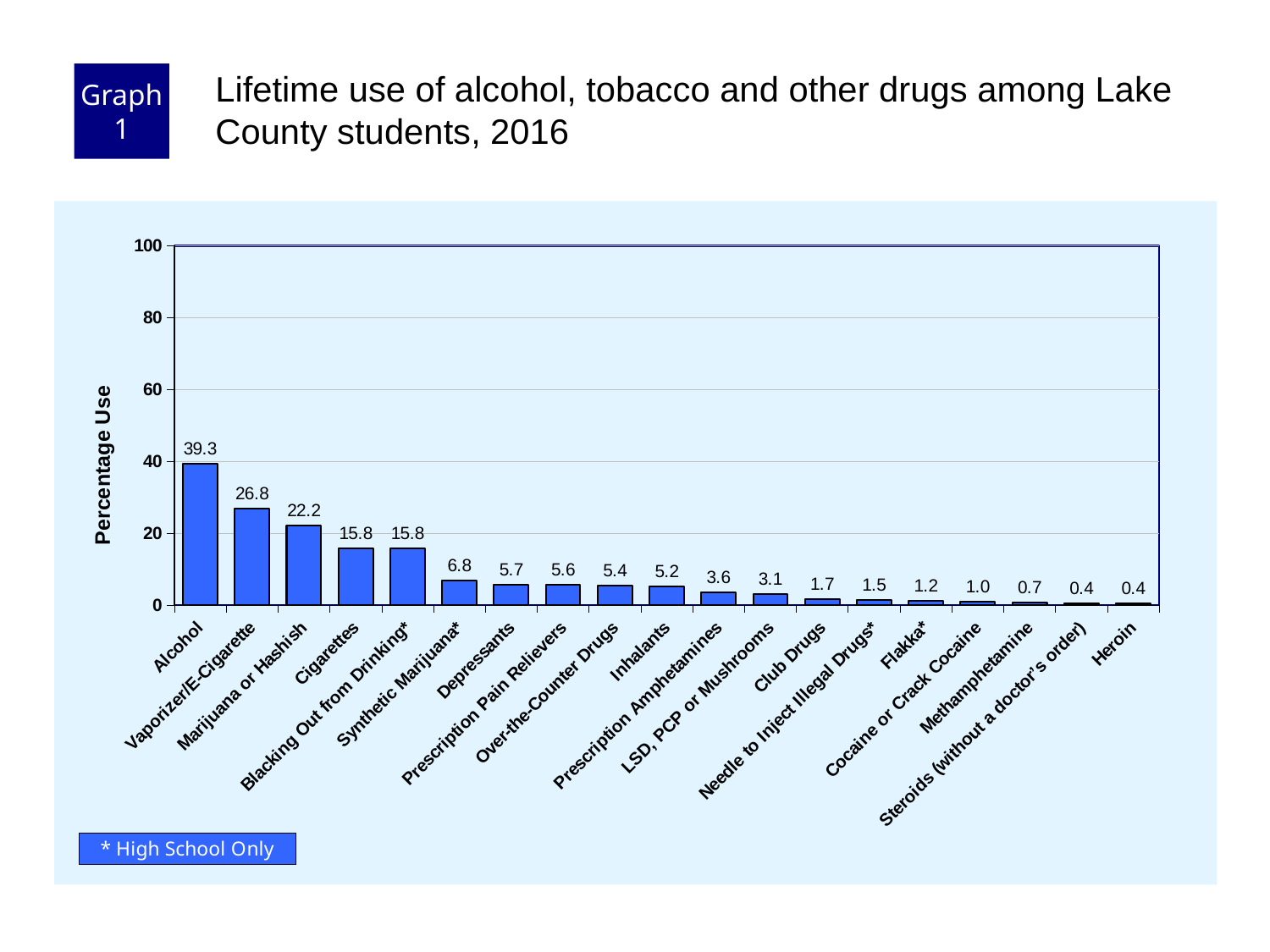
Is the value for Vaporizer/E-Cigarette greater or less than 20? greater What is the label of the y axis? Percentage Use How many categories are shown on the x axis? 19 What is the percentage use for Alcohol? 39.3 What is the difference in percentage use between Alcohol and Marijuana or Hashish? 17.1 What is the percentage use for Methamphetamine? 0.7 Which has a higher percentage use, Depressants or Club Drugs? Depressants What is the percentage use for Vaporizer/E-Cigarette? 26.8 What kind of chart is shown on the slide? Bar chart What is the percentage use for Synthetic Marijuana*? 6.8 What is the difference in percentage use between Cigarettes and Inhalants? 10.6 Which category has the highest percentage use? Alcohol